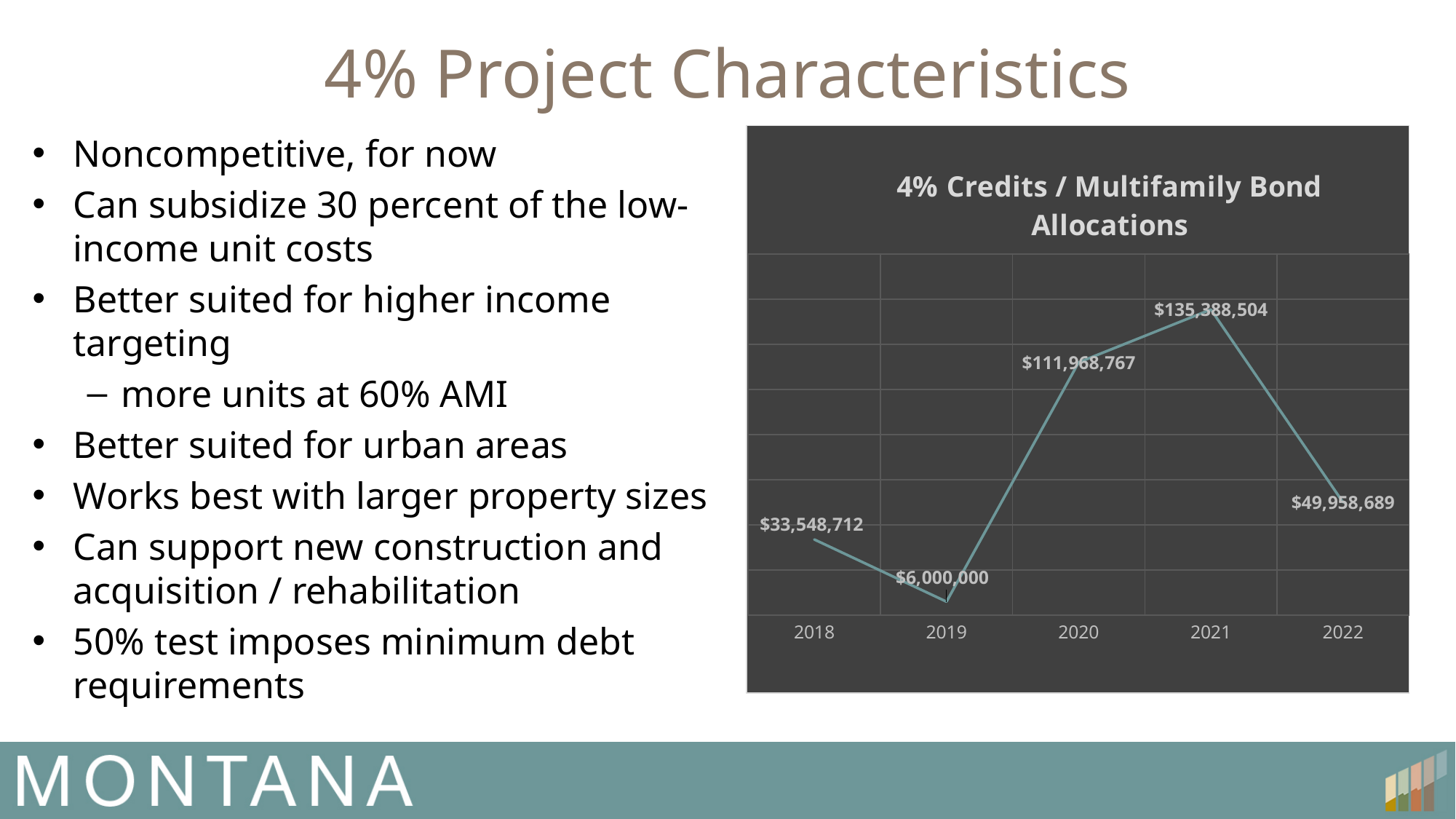
What is the value for 2021 in the 4% Credits / Multifamily Bond Allocations chart? $135,388,504 What kind of chart is the 4% Credits / Multifamily Bond Allocations chart? Line chart Which year has the larger value in the 4% Credits / Multifamily Bond Allocations chart, 2018 or 2022? 2022 Does the value rise or fall from 2021 to 2022 in the 4% Credits / Multifamily Bond Allocations chart? Fall How many years are plotted in the 4% Credits / Multifamily Bond Allocations chart? 5 What is the value for 2019 in the 4% Credits / Multifamily Bond Allocations chart? $6,000,000 What is the value for 2018 in the 4% Credits / Multifamily Bond Allocations chart? $33,548,712 What is the value for 2022 in the 4% Credits / Multifamily Bond Allocations chart? $49,958,689 Which year has the highest value in the 4% Credits / Multifamily Bond Allocations chart? 2021 What is the difference between the 2021 and 2020 values in the 4% Credits / Multifamily Bond Allocations chart? $23,419,737 What is the difference between the 2018 and 2019 values in the 4% Credits / Multifamily Bond Allocations chart? $27,548,712 Which year has the lowest value in the 4% Credits / Multifamily Bond Allocations chart? 2019